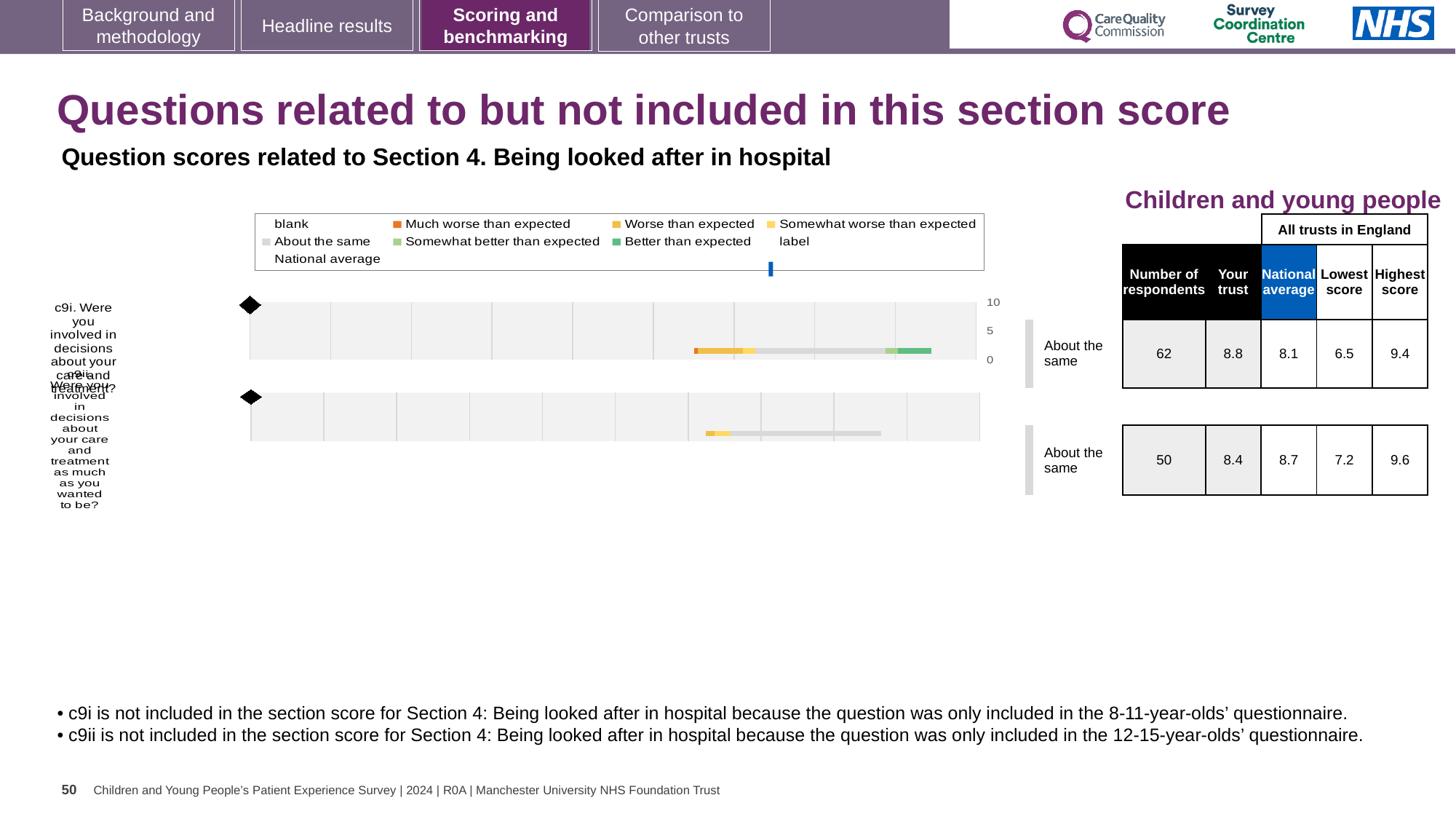
According to the table beside the chart, what is the 'Your trust' score for c9i? 8.8 How many entries does the chart legend list? 9 What is the highest score across all trusts in England for c9ii, as shown in the table beside the chart? 9.6 What is the subtitle describing the chart's question scores? Question scores related to Section 4. Being looked after in hospital What benchmark label is shown next to the bar for c9ii? About the same What is the difference between the 'Your trust' score and the national average for c9i? 0.7 According to the table beside the chart, what is the national average for c9ii? 8.7 What colour represents 'Better than expected' in the chart legend? Green How many respondents are listed for c9i in the table beside the chart? 62 What kind of chart is shown on the slide? Bar chart How many questions (bars) are plotted in the chart? 2 For c9i, which is higher: the 'Your trust' score or the national average? Your trust